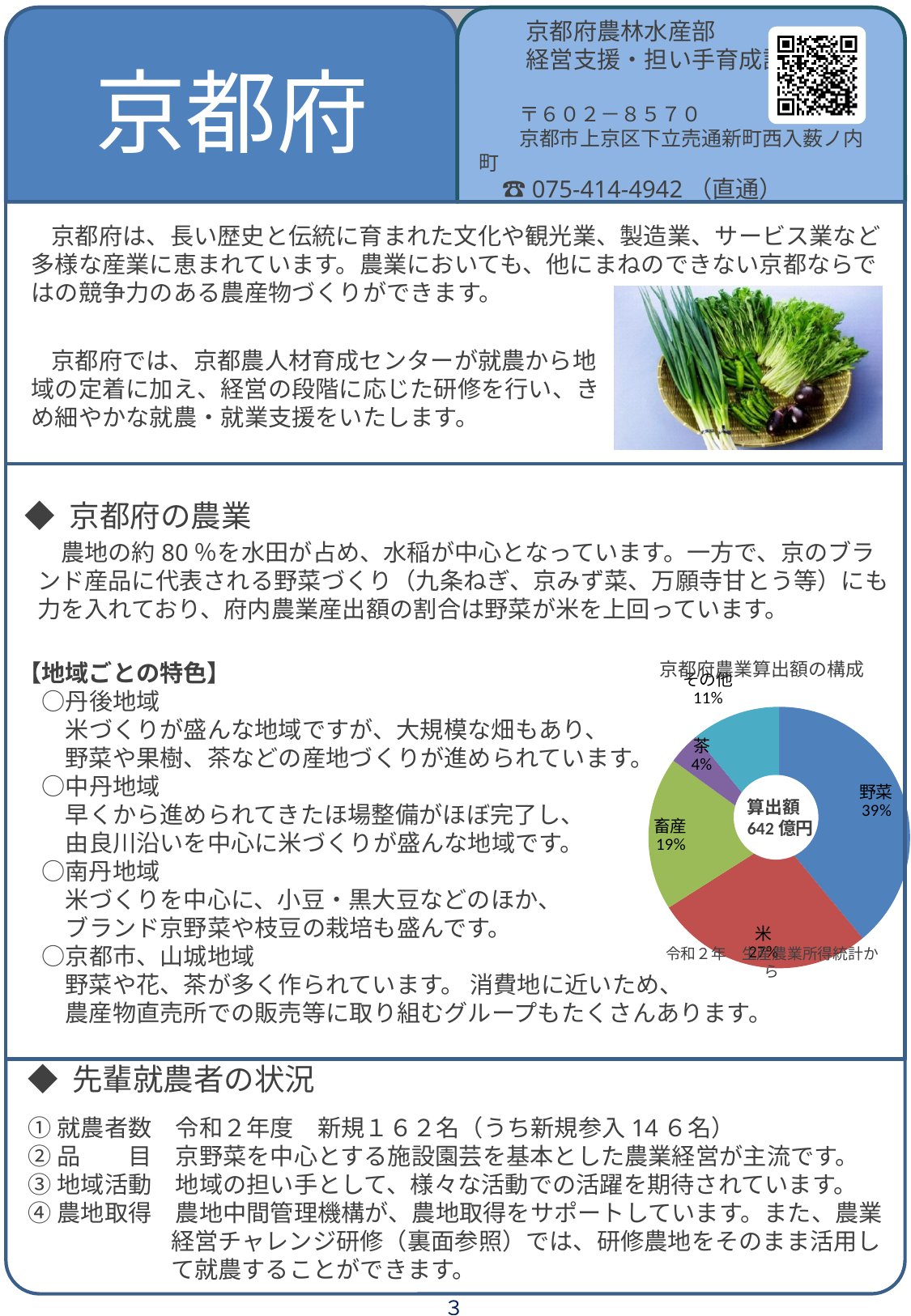
What share of the pie does その他 account for? 11% What share of the pie does 野菜 account for? 39% Which category has the largest share of the pie? 野菜 What share of the pie does 畜産 account for? 19% How many slices does the pie chart have? 5 What is the title of the pie chart? 京都府農業算出額の構成 What total amount is printed in the centre of the pie chart? 642 億円 Which category has the smallest share of the pie? 茶 What is the difference in percentage points between the 野菜 share and the 米 share? 12 What kind of chart is shown on the slide? pie chart